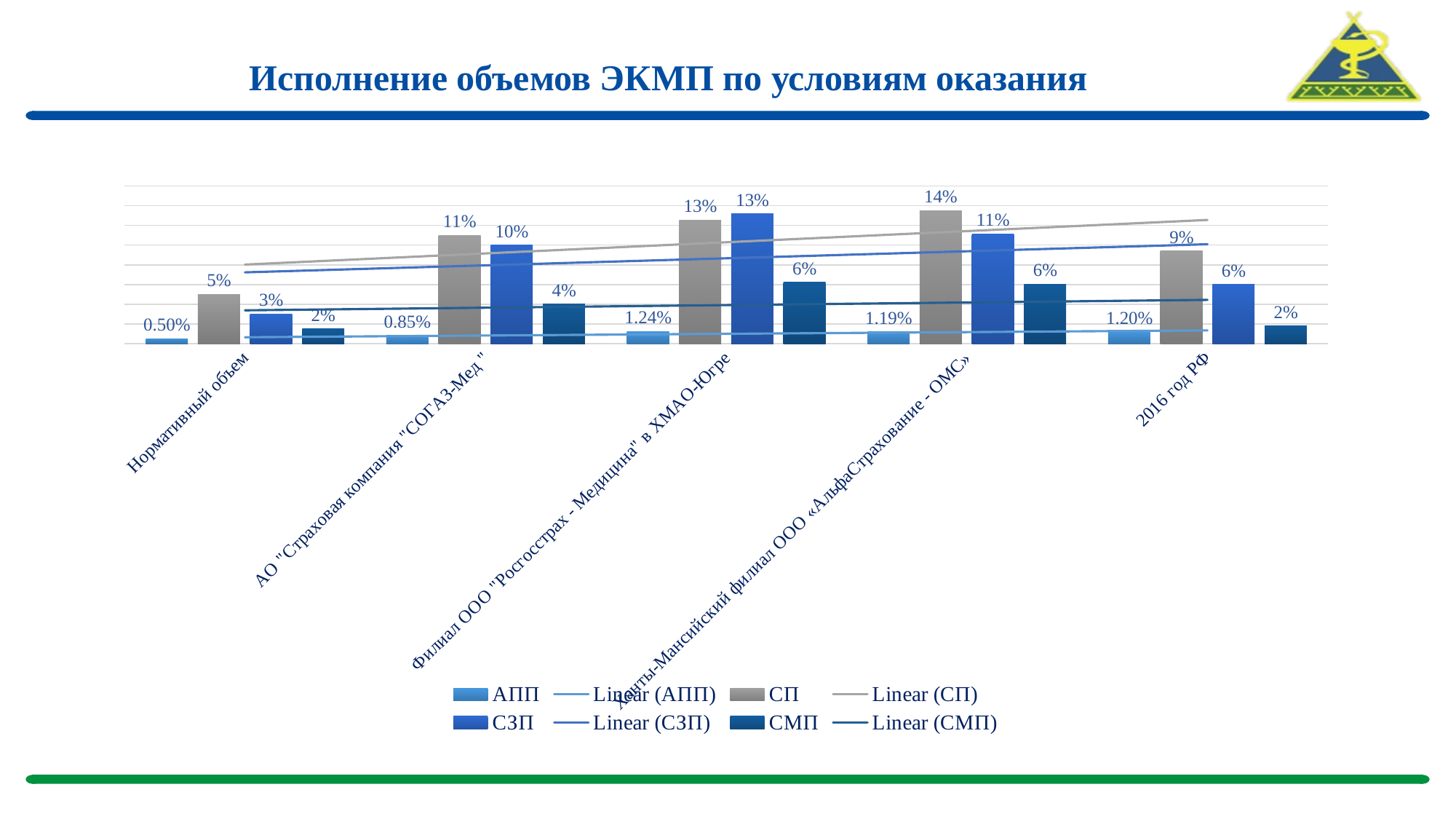
What is the СП value for Ханты-Мансийский филиал ООО «АльфаСтрахование - ОМС»? 14% How many categories are shown on the x axis? 5 Which category has the lowest АПП value? Нормативный объем Which category has the highest СП value? Ханты-Мансийский филиал ООО «АльфаСтрахование - ОМС» What is the АПП value for Нормативный объем? 0.50% What is the СЗП value for АО "Страховая компания "СОГАЗ-Мед"? 10% How many entries does the legend list? 8 Which is larger: the СМП value for АО "Страховая компания "СОГАЗ-Мед" or the СМП value for Филиал ООО "Росгосстрах - Медицина" в ХМАО-Югре? Филиал ООО "Росгосстрах - Медицина" в ХМАО-Югре What kind of chart is shown on the slide? Bar chart What is the difference between the СЗП values for Филиал ООО "Росгосстрах - Медицина" в ХМАО-Югре and 2016 год РФ? 7% What is the СМП value for 2016 год РФ? 2% What is the title of the slide? Исполнение объемов ЭКМП по условиям оказания